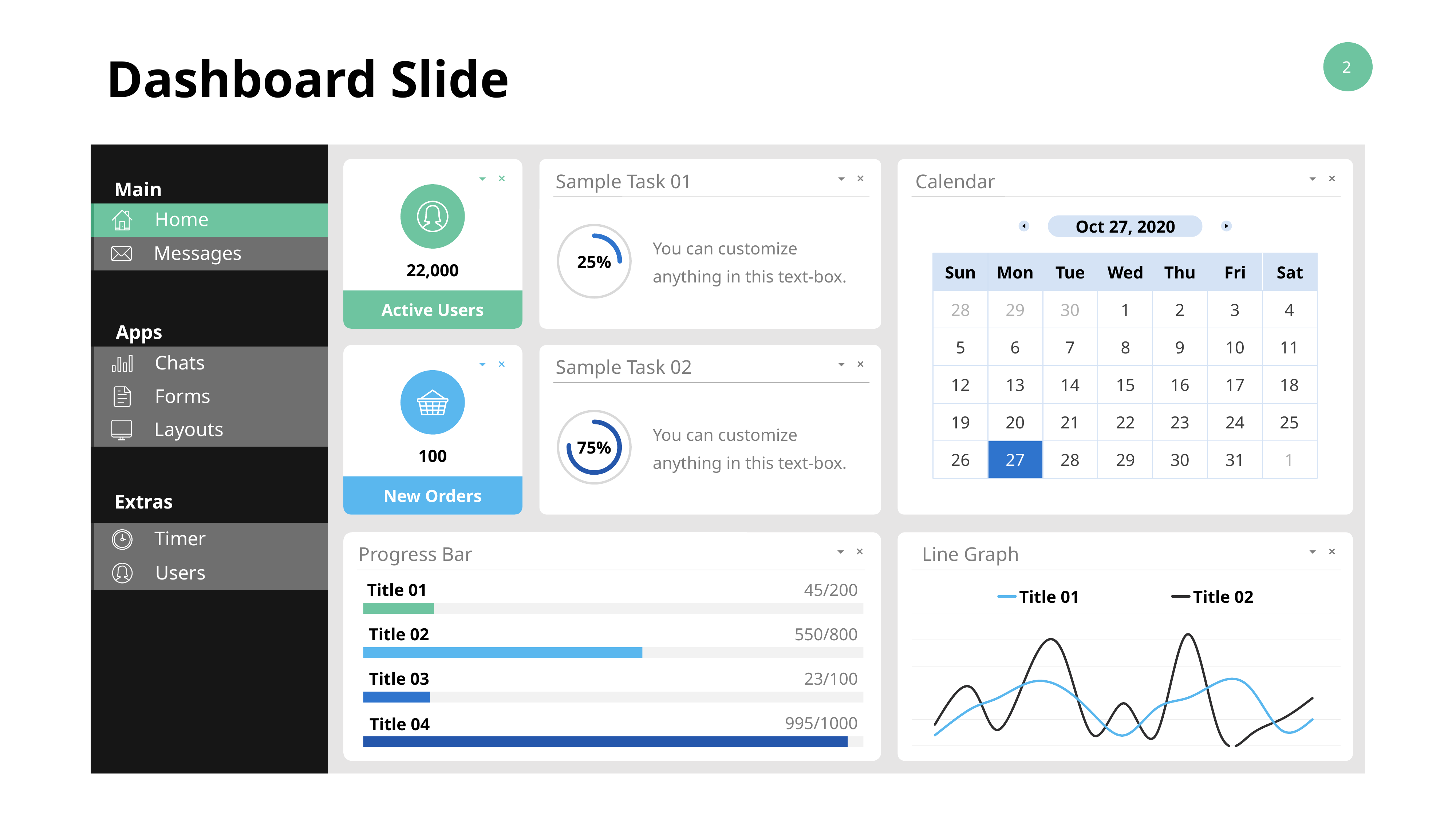
How many series does the legend of the Line Graph panel list? 2 In the Progress Bar panel, which title has the highest value? Title 04 In the Progress Bar panel, what is the difference between the value for Title 02 and the value for Title 01? 505 In the Progress Bar panel, how many progress bars are shown? 4 What percentage is shown in the Sample Task 01 panel? 25% In the Progress Bar panel, what value is shown for Title 02? 550/800 What kind of chart is shown in the Line Graph panel? Line chart What percentage is shown in the Sample Task 02 panel? 75% Which is larger, the percentage in Sample Task 01 or the percentage in Sample Task 02? Sample Task 02 In the Progress Bar panel, what value is shown for Title 04? 995/1000